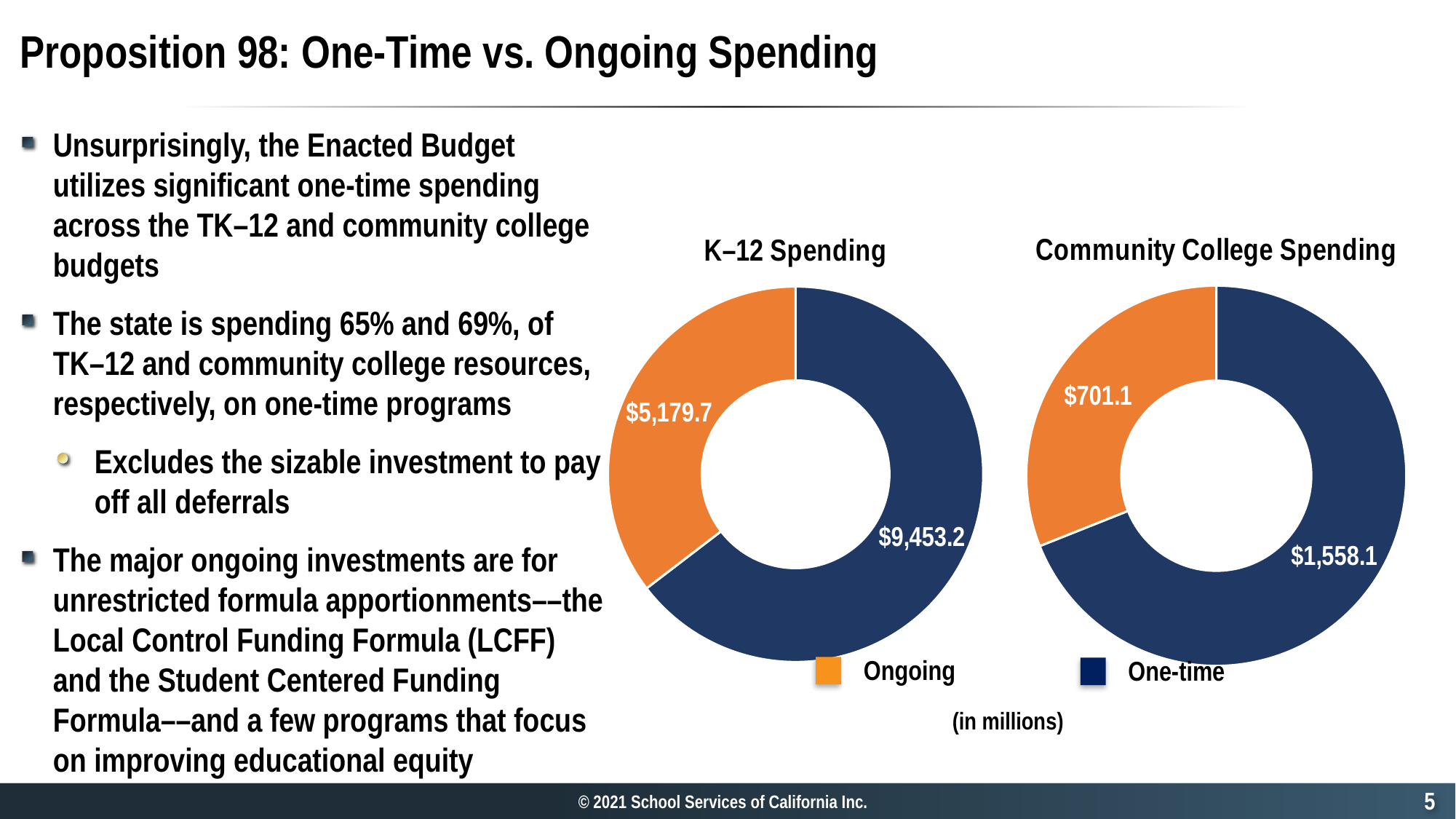
What colour represents One-time spending in the charts? Dark blue In the K–12 Spending chart, what is the total of the two segments? $14,632.9 In the K–12 Spending chart, what is the value for Ongoing spending? $5,179.7 In the Community College Spending chart, what is the difference between One-time and Ongoing spending? $857.0 How many categories does the legend list for the charts? 2 What kind of chart is the Community College Spending chart? Doughnut (pie) chart In the K–12 Spending chart, which category is larger, Ongoing or One-time? One-time In the K–12 Spending chart, what is the difference between One-time and Ongoing spending? $4,273.5 In the K–12 Spending chart, what is the value for One-time spending? $9,453.2 In the Community College Spending chart, what is the value for One-time spending? $1,558.1 In the Community College Spending chart, which category is the smallest? Ongoing In the Community College Spending chart, what is the value for Ongoing spending? $701.1